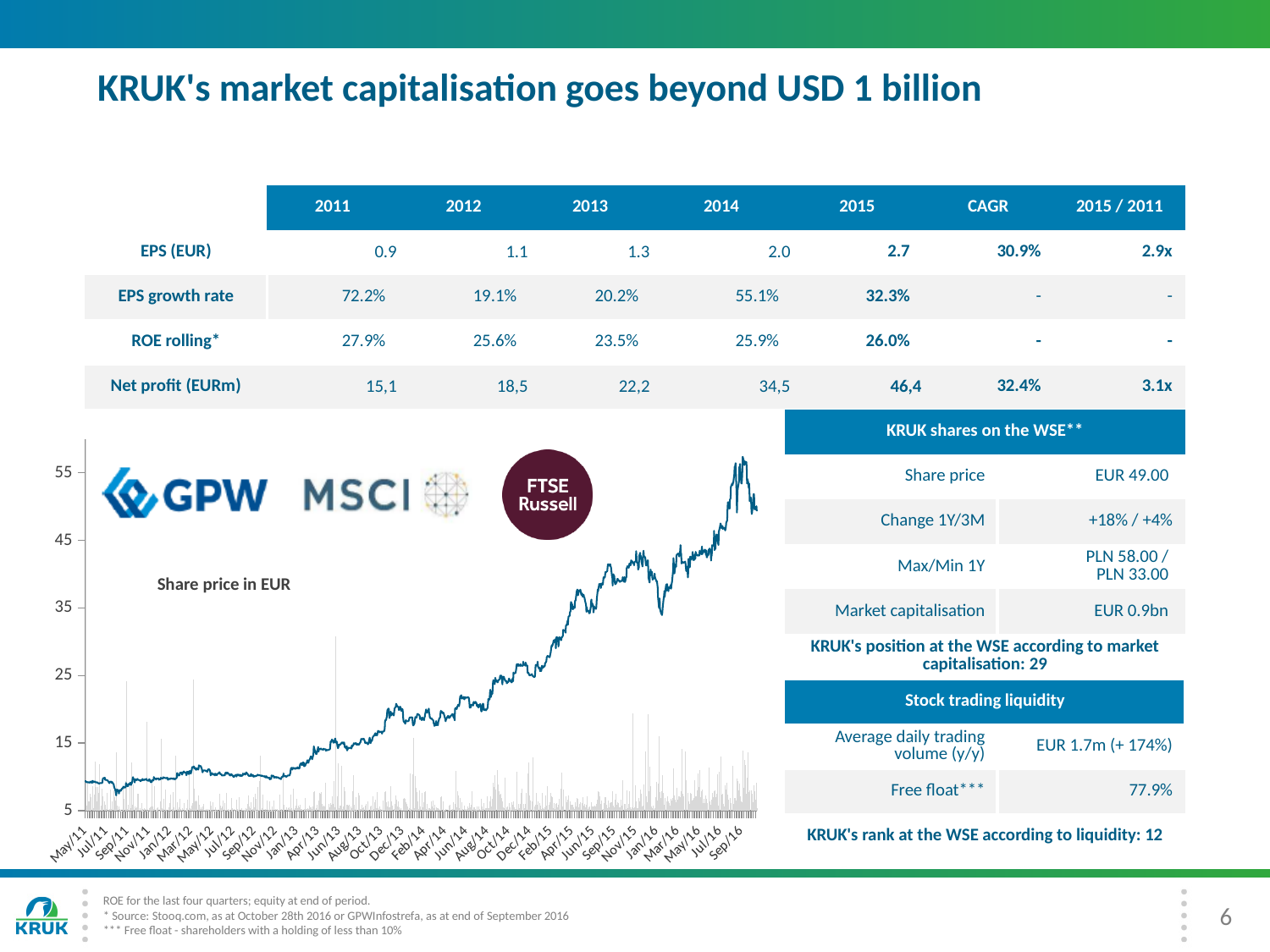
In the "Share price in EUR" chart, is the value at May/11 greater or less than 15? less Does the share price in the "Share price in EUR" chart rise or fall overall from May/11 to Sep/16? rise In the "Share price in EUR" chart, is the value at Jan/16 greater or less than 35? greater What is the highest tick shown on the y axis of the "Share price in EUR" chart? 55 What kind of chart is the "Share price in EUR" chart? line chart In the "Share price in EUR" chart, is the value at Sep/16 greater or less than 45? greater In the "Share price in EUR" chart, is the share price higher at Sep/16 or at May/11? Sep/16 What is the title of the chart on the slide? Share price in EUR